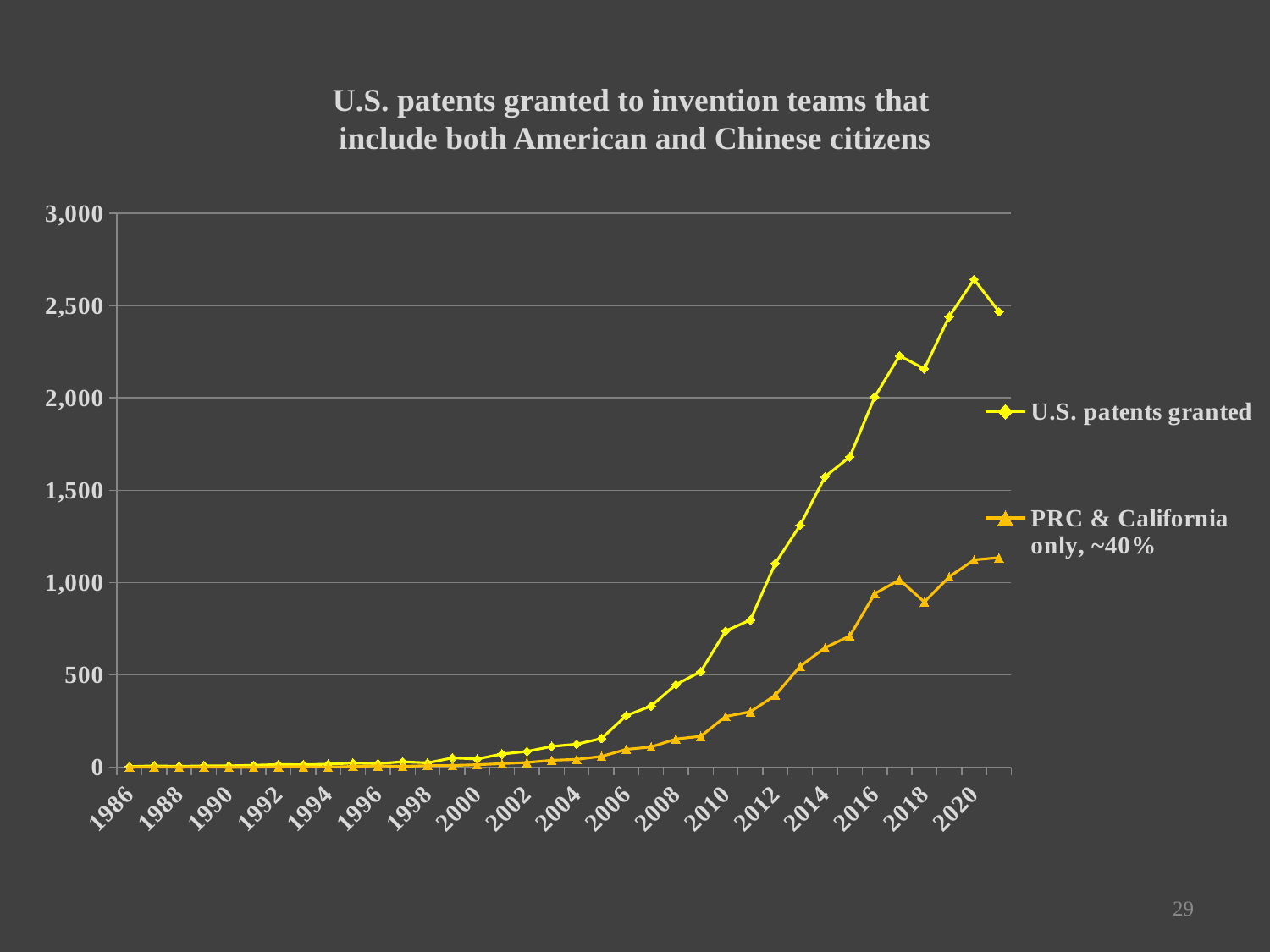
Is the value for U.S. patents granted in 2020 greater or less than 2,500? greater In which year does the U.S. patents granted series reach its highest value? 2020 Is the value for PRC & California only in 2020 greater or less than 1,000? greater Which series is drawn with triangle markers? PRC & California only, ~40% What is the title of the chart? U.S. patents granted to invention teams that include both American and Chinese citizens How many series does the legend list? 2 Overall, do the values for U.S. patents granted rise or fall from 1986 to 2020? rise Is the value for U.S. patents granted in 2010 greater or less than 500? greater In 2018, which series has the larger value: U.S. patents granted or PRC & California only? U.S. patents granted What kind of chart is shown on the slide? line chart